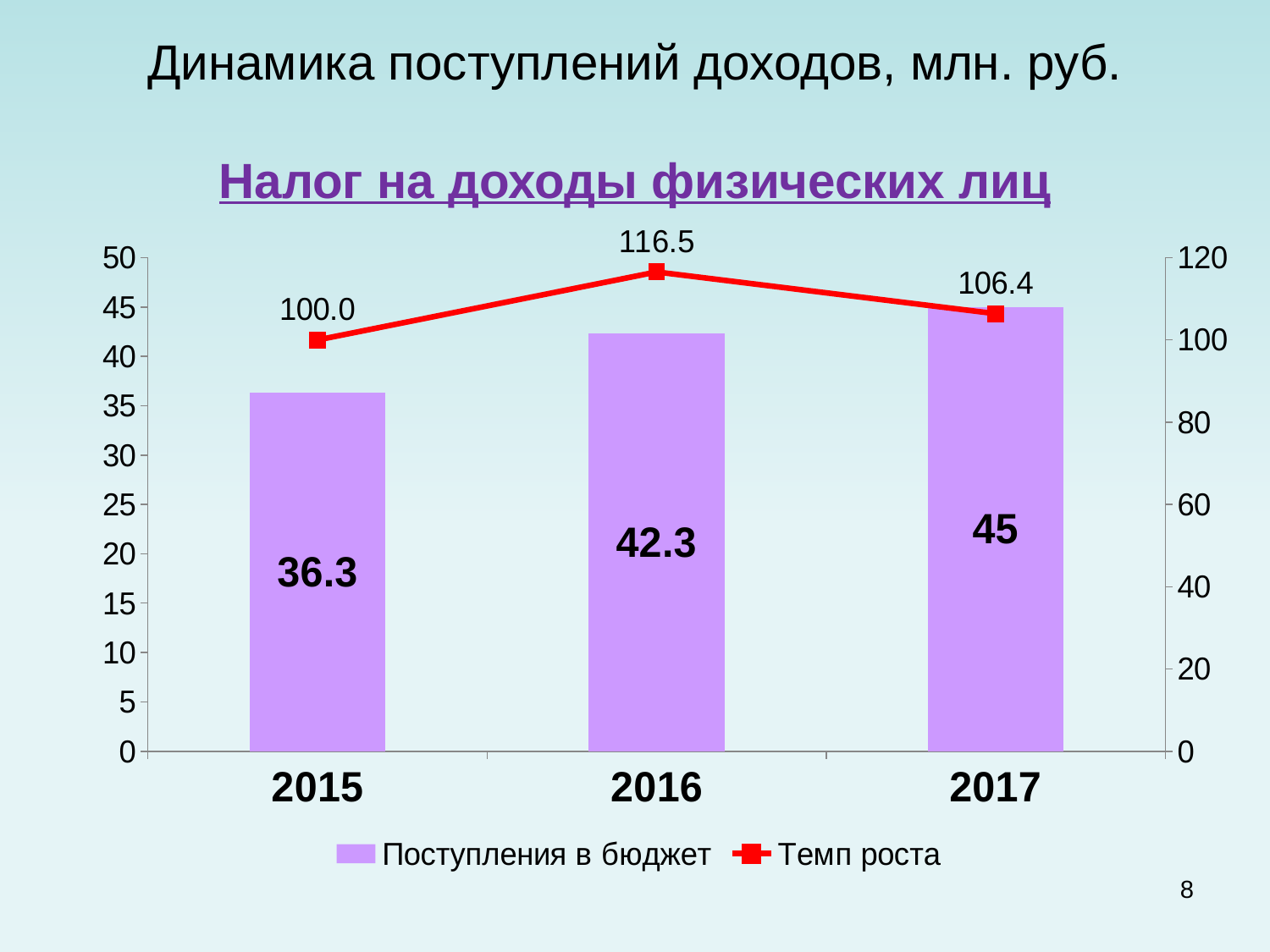
What is the value of Темп роста for 2017? 106.4 Which year has the highest Поступления в бюджет? 2017 How many years are shown on the x axis? 3 Which is larger: Темп роста in 2016 or in 2017? 2016 What kind of chart is used for the Поступления в бюджет series? Bar chart Which year has the lowest Темп роста? 2015 What is the value of Поступления в бюджет for 2016? 42.3 What is the value of Поступления в бюджет for 2015? 36.3 What is the title of the chart? Налог на доходы физических лиц What is the difference between Поступления в бюджет in 2017 and 2015? 8.7 Do the Поступления в бюджет values rise or fall from 2015 to 2017? Rise How many series does the legend list? 2